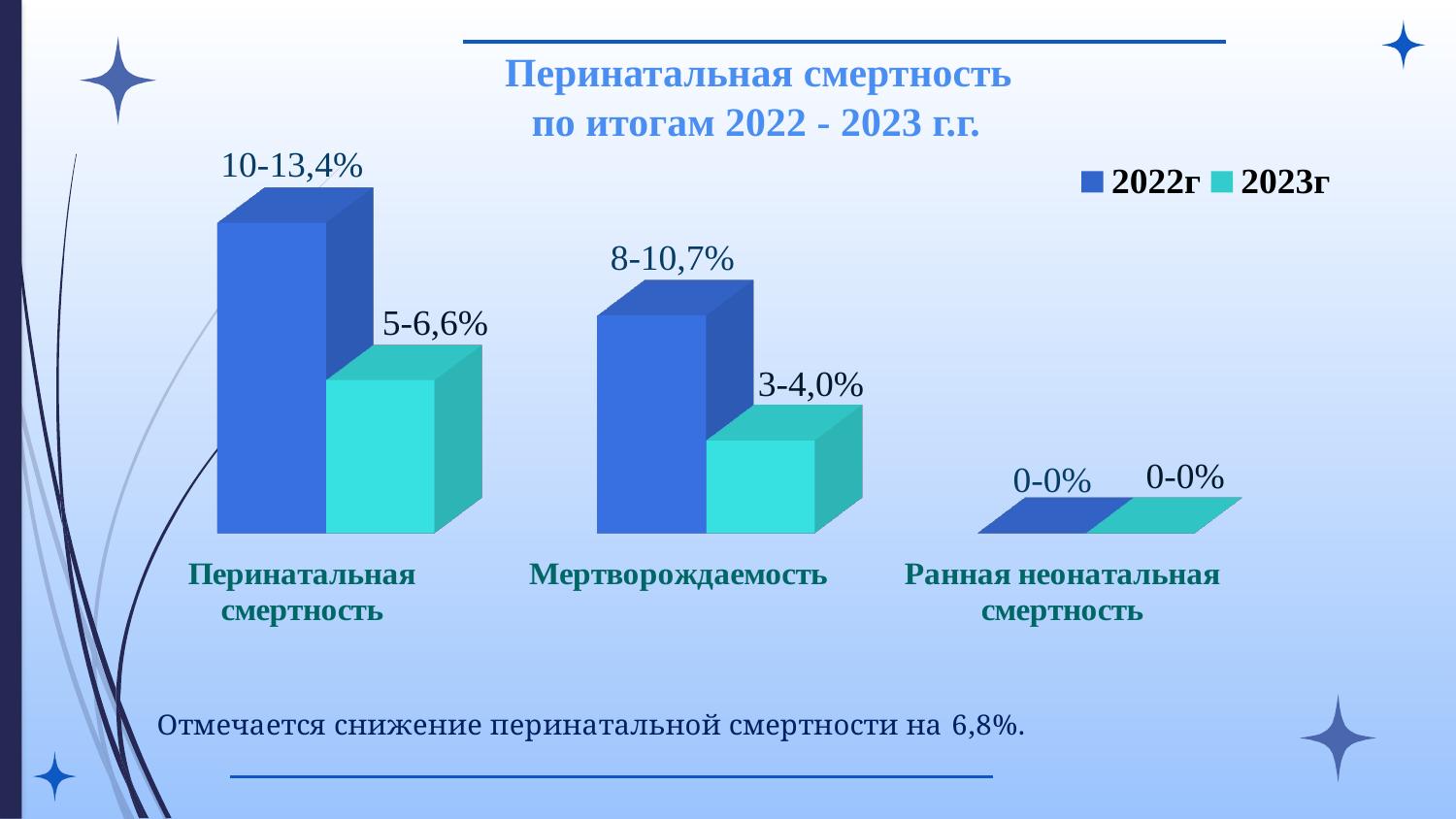
How many categories are shown on the x axis of the chart? 3 What is the data label for 2023г in the Мертворождаемость category? 3-4,0% What is the title of the chart? Перинатальная смертность по итогам 2022 - 2023 г.г. What is the data label for 2022г in the Мертворождаемость category? 8-10,7% What kind of chart is shown on the slide? Bar chart In the Мертворождаемость category, which series has the larger value, 2022г or 2023г? 2022г What is the data label for 2023г in the Перинатальная смертность category? 5-6,6% What is the data label for 2022г in the Перинатальная смертность category? 10-13,4% How many series does the legend list? 2 Which category has the lowest value for 2023г? Ранная неонатальная смертность Which category has the highest value for 2022г? Перинатальная смертность What is the data label for 2022г in the Ранная неонатальная смертность category? 0-0%